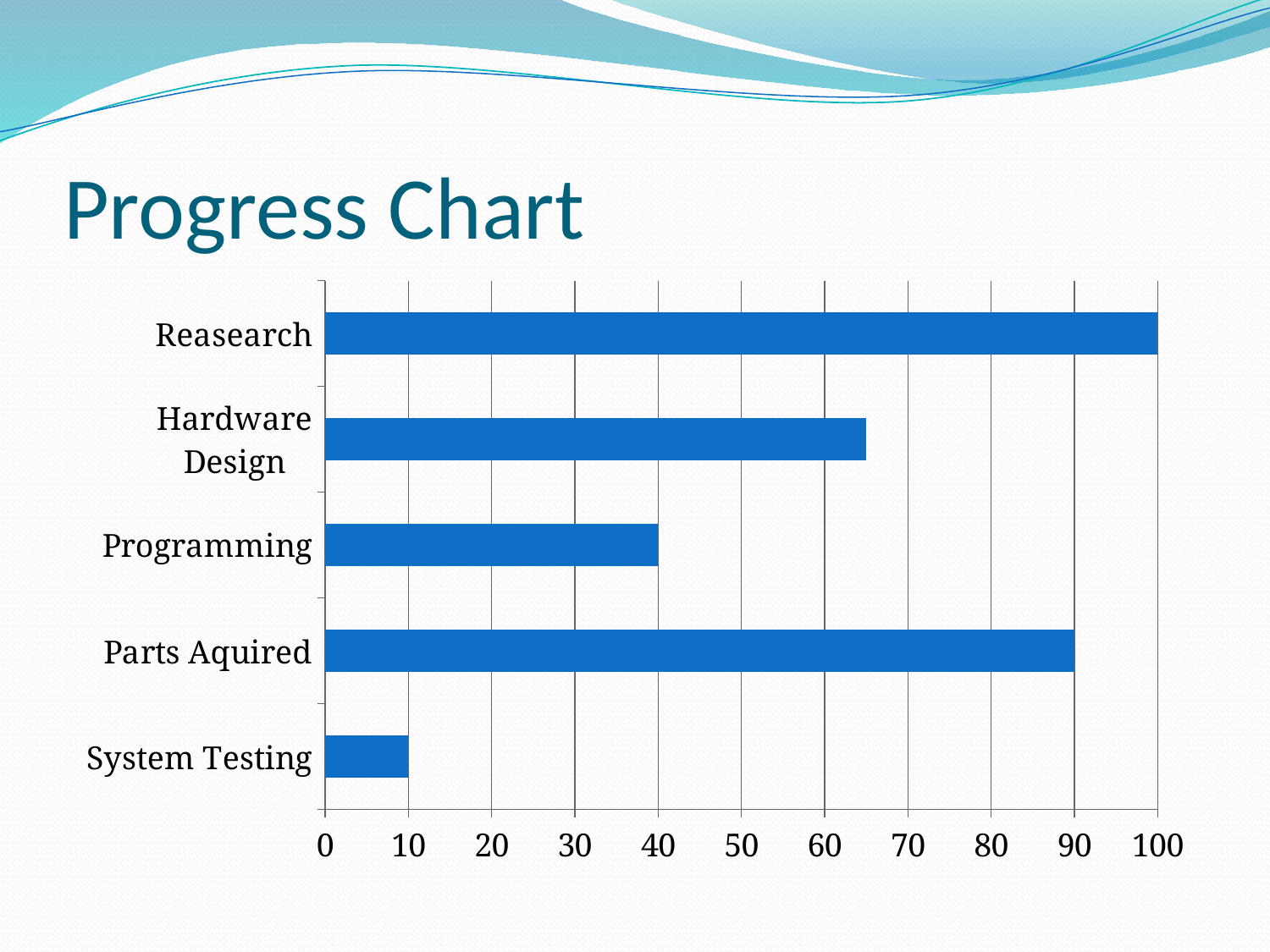
Which category has the highest value? Reasearch What is the value for Reasearch? 100 What is the value for Parts Aquired? 90 Is the value for Hardware Design greater or less than 60? greater What is the value for System Testing? 10 What is the difference between the values for Parts Aquired and Programming? 50 What is the value for Programming? 40 What is the title of the slide? Progress Chart Which is larger, the value for Hardware Design or the value for Parts Aquired? Parts Aquired Which category has the lowest value? System Testing How many categories are shown in the chart? 5 What kind of chart is shown on the slide? Bar chart